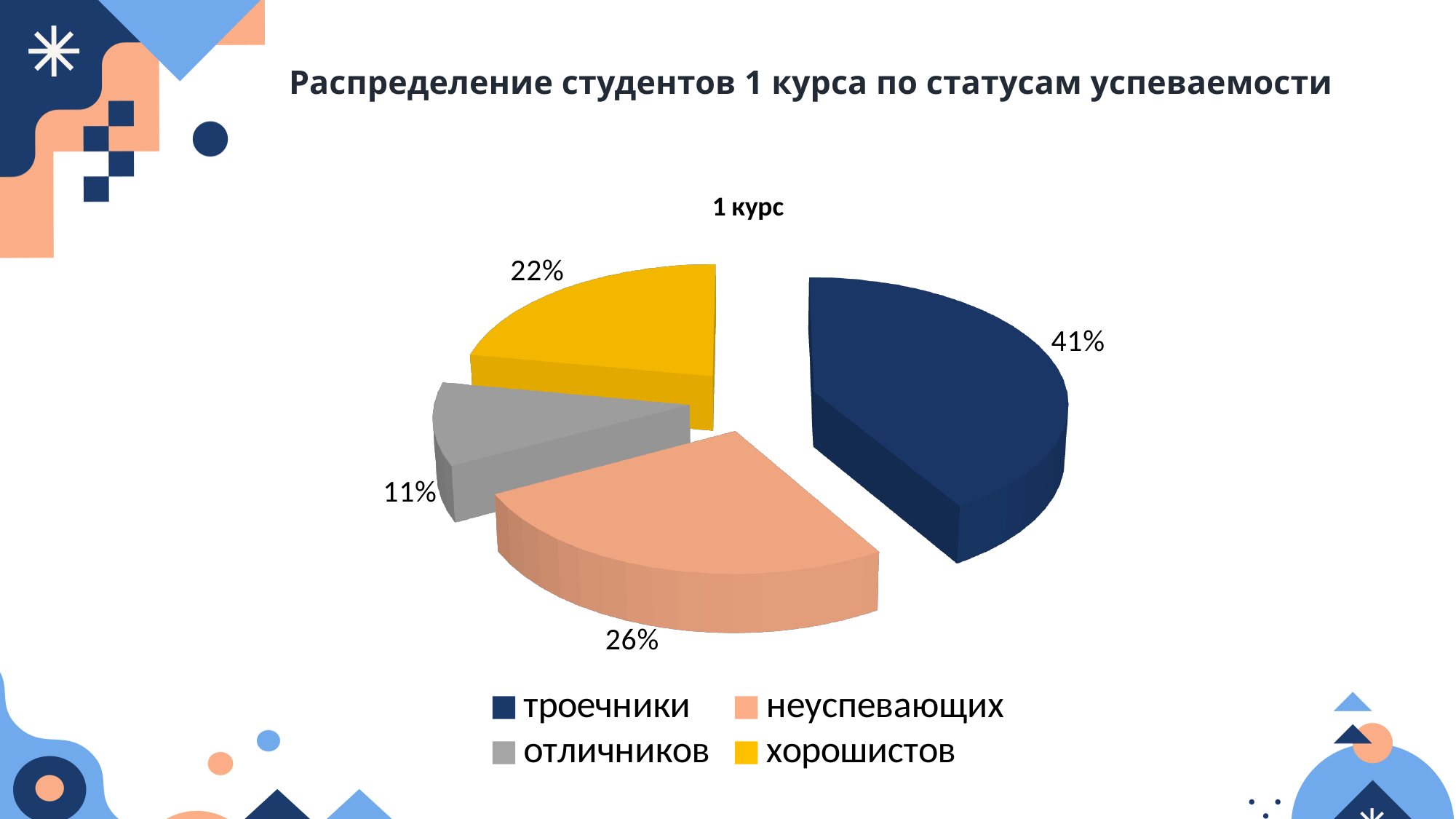
How many slices does the pie chart have? 4 What percentage of the pie chart is the slice for хорошистов? 22% What is the difference in percentage points between the троечники slice and the хорошистов slice? 19 Which category has the smallest share of the pie chart? отличников What percentage of the pie chart is the slice for неуспевающих? 26% What type of chart is shown on the slide? pie chart What is the title shown directly above the pie chart? 1 курс What colour is the slice for хорошистов in the pie chart? yellow Which category has the largest share of the pie chart? троечники What percentage of the pie chart is the slice for троечники? 41% What percentage of the pie chart is the slice for отличников? 11% Which slice is larger: неуспевающих or хорошистов? неуспевающих